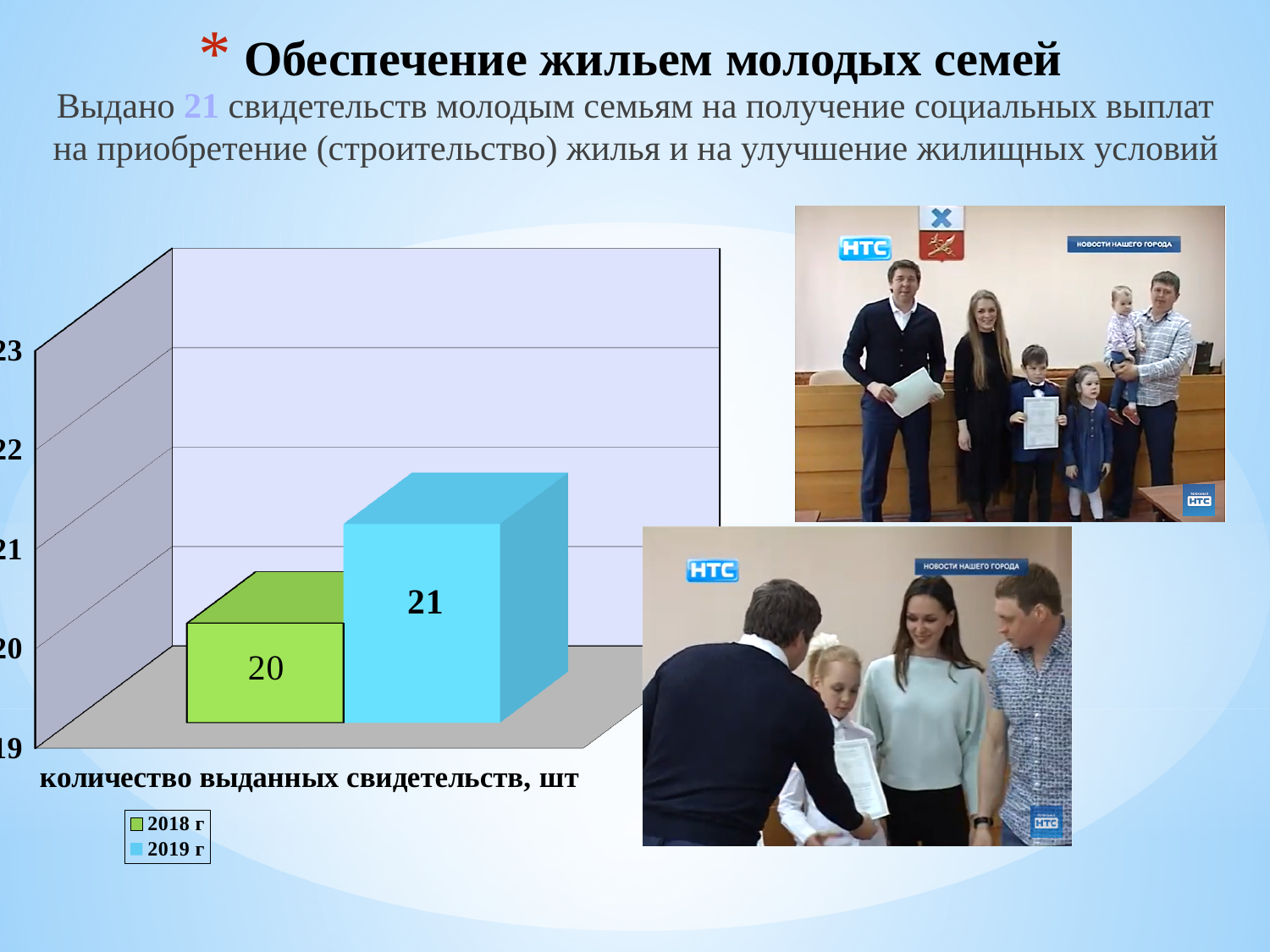
Which series has the highest value in the chart? 2019 г What colour is the bar for 2019 г? blue What is the category axis label of the chart? количество выданных свидетельств, шт What is the difference between the 2019 г and 2018 г values? 1 What is the value for 2018 г in the chart? 20 What is the value for 2019 г in the chart? 21 Do the values rise or fall from 2018 г to 2019 г? rise Which year has the higher value, 2018 г or 2019 г? 2019 г How many series does the legend list? 2 Is the value for 2019 г greater or less than 22? less Which series has the lowest value in the chart? 2018 г What kind of chart is shown on the slide? bar chart